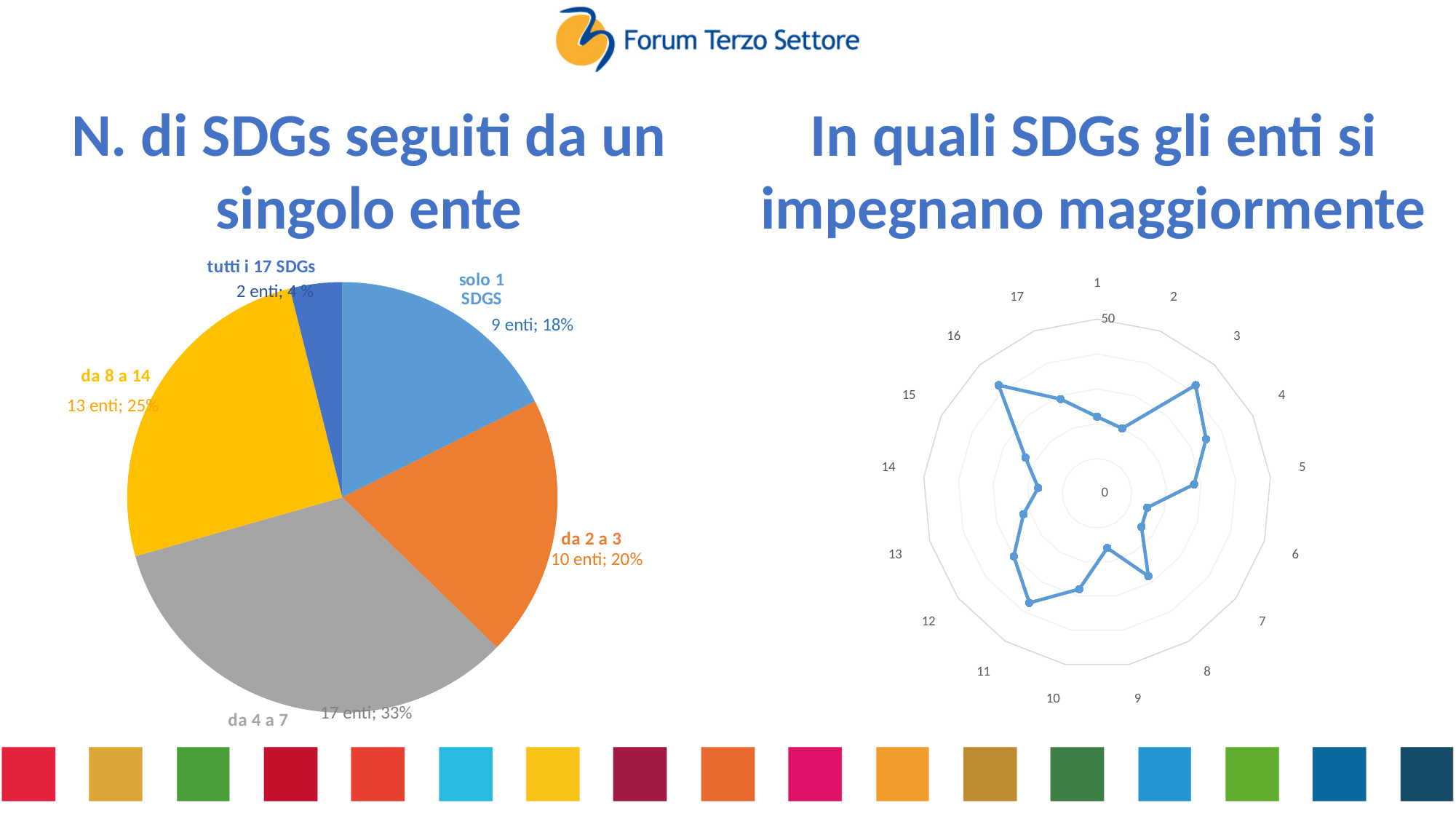
In the pie chart 'N. di SDGs seguiti da un singolo ente', which category has the smallest slice? tutti i 17 SDGs How many categories does the pie chart 'N. di SDGs seguiti da un singolo ente' have? 5 What kind of chart is the chart on the right, 'In quali SDGs gli enti si impegnano maggiormente'? Radar chart In the pie chart 'N. di SDGs seguiti da un singolo ente', which category has the largest slice? da 4 a 7 In the radar chart 'In quali SDGs gli enti si impegnano maggiormente', which has the larger value: SDG 1 or SDG 3? SDG 3 In the radar chart 'In quali SDGs gli enti si impegnano maggiormente', is the value for SDG 3 greater or less than 50? less In the pie chart 'N. di SDGs seguiti da un singolo ente', what percentage of the pie is 'da 4 a 7'? 33% In the pie chart 'N. di SDGs seguiti da un singolo ente', which has more enti: 'da 8 a 14' or 'da 2 a 3'? da 8 a 14 How many categories (SDGs) are plotted on the radar chart 'In quali SDGs gli enti si impegnano maggiormente'? 17 In the pie chart 'N. di SDGs seguiti da un singolo ente', what percentage is shown for 'da 8 a 14'? 25% In the pie chart 'N. di SDGs seguiti da un singolo ente', how many enti follow 'solo 1 SDGS'? 9 enti In the pie chart 'N. di SDGs seguiti da un singolo ente', how many more enti are in 'da 4 a 7' than in 'da 2 a 3'? 7 enti